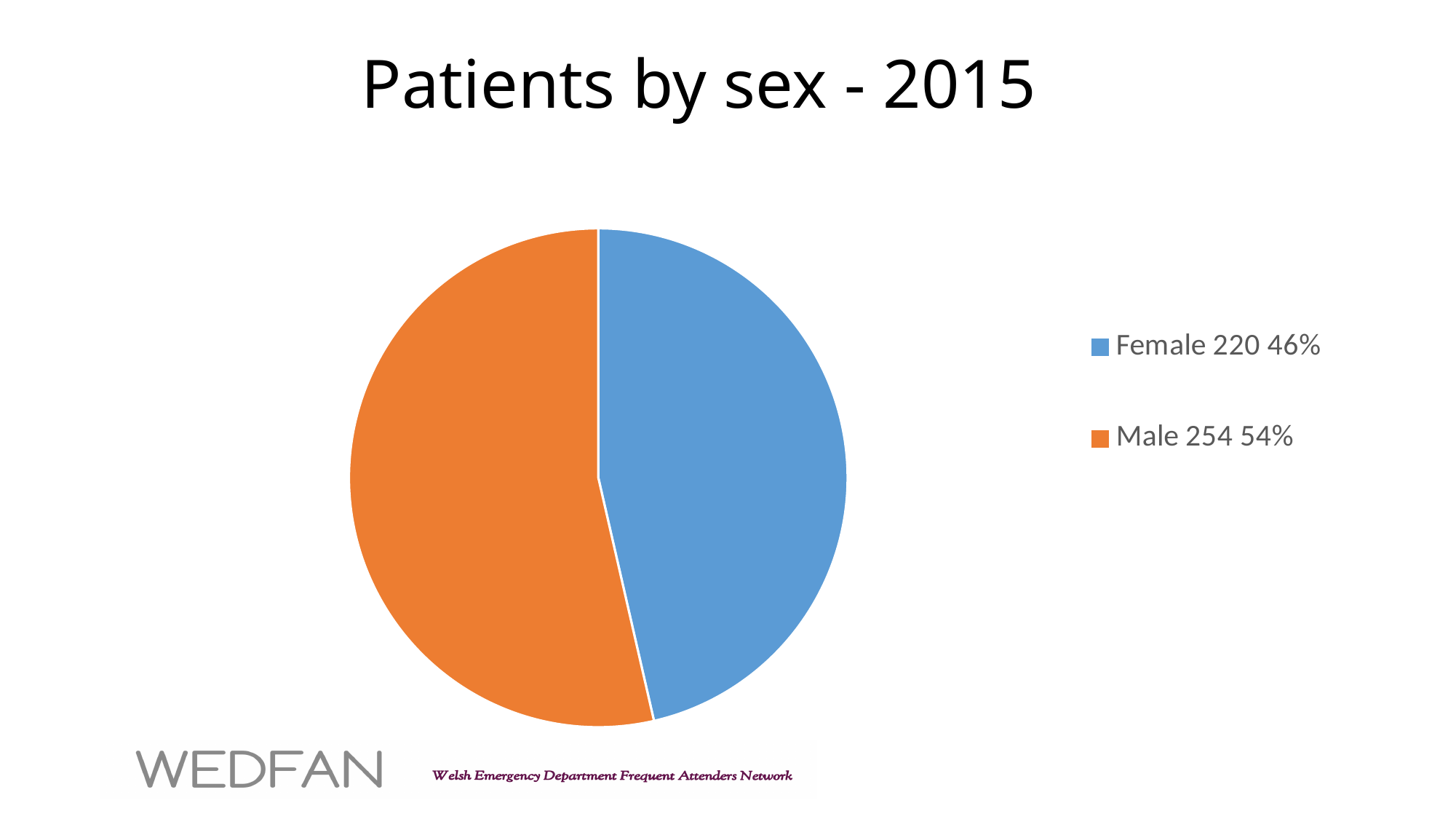
What is the title of the chart? Patients by sex - 2015 Which sex has the larger number of patients? Male How many patients were male in 2015? 254 What is the total number of patients shown in the chart? 474 What share of patients were female? 46% How many categories does the pie chart have? 2 How many more male patients than female patients were there? 34 What kind of chart is shown on the slide? pie chart How many patients were female in 2015? 220 What share of patients were male? 54% Which sex has the smaller number of patients? Female Which colour represents the Male slice? orange